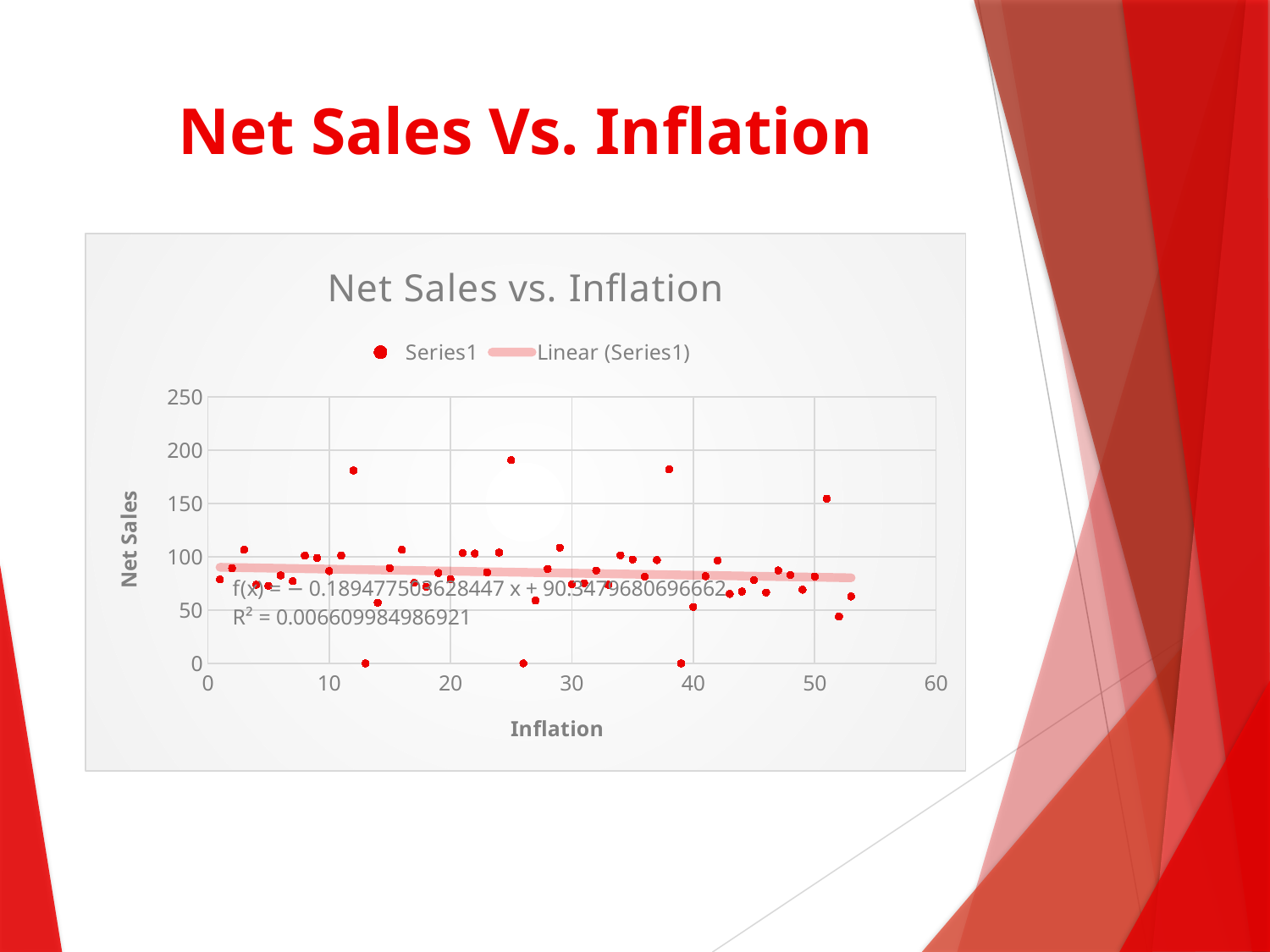
What is the title of the chart? Net Sales vs. Inflation Does the linear trendline rise or fall as Inflation increases? fall Is the Net Sales value of the point near Inflation 51 greater or less than 100? greater Is the highest Net Sales point on the chart greater or less than 150? greater What is the maximum value shown on the Inflation axis? 60 What R² value is printed on the chart? R² = 0.0066099984986921 How many entries does the chart legend list? 2 What is the maximum value shown on the Net Sales axis? 250 What is the label on the vertical axis of the chart? Net Sales What kind of chart is shown on the slide? scatter chart